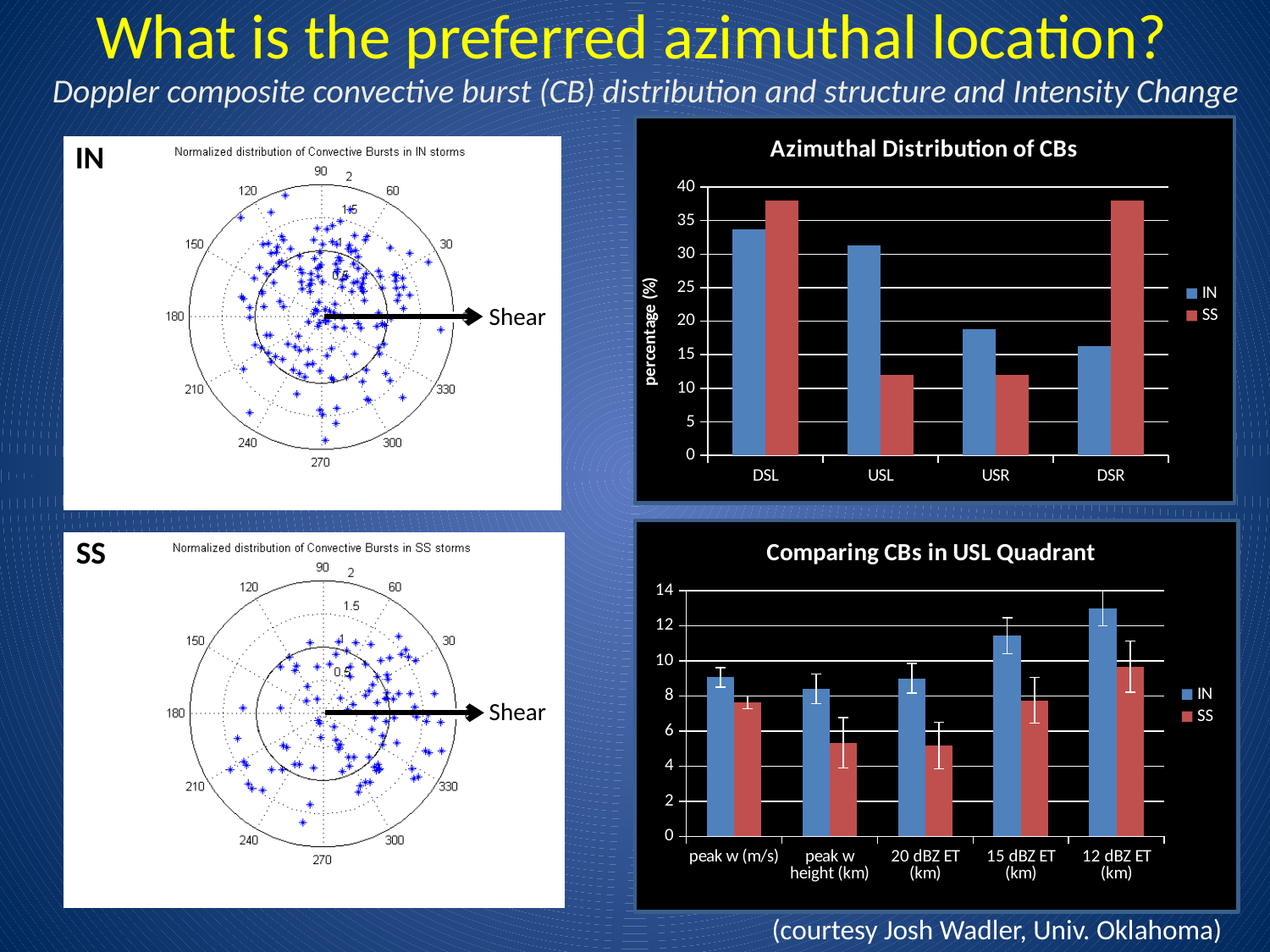
In the 'Azimuthal Distribution of CBs' chart, is the SS value for DSR greater or less than 35? greater In the 'Azimuthal Distribution of CBs' chart, is the IN value for DSL greater or less than 30? greater In the 'Comparing CBs in USL Quadrant' chart, how many categories are shown on the x axis? 5 In the 'Azimuthal Distribution of CBs' chart, is the SS value for USL greater or less than 15? less In the 'Azimuthal Distribution of CBs' chart, what kind of chart is shown? bar chart In the 'Azimuthal Distribution of CBs' chart, what is the label of the y axis? percentage (%) In the 'Azimuthal Distribution of CBs' chart, how many series does the legend list? 2 In the 'Comparing CBs in USL Quadrant' chart, which category has the highest IN value? 12 dBZ ET (km) In the 'Azimuthal Distribution of CBs' chart, which series has the larger value for USL, IN or SS? IN In the 'Comparing CBs in USL Quadrant' chart, which series has the larger value for 15 dBZ ET (km), IN or SS? IN In the 'Azimuthal Distribution of CBs' chart, how many categories are shown on the x axis? 4